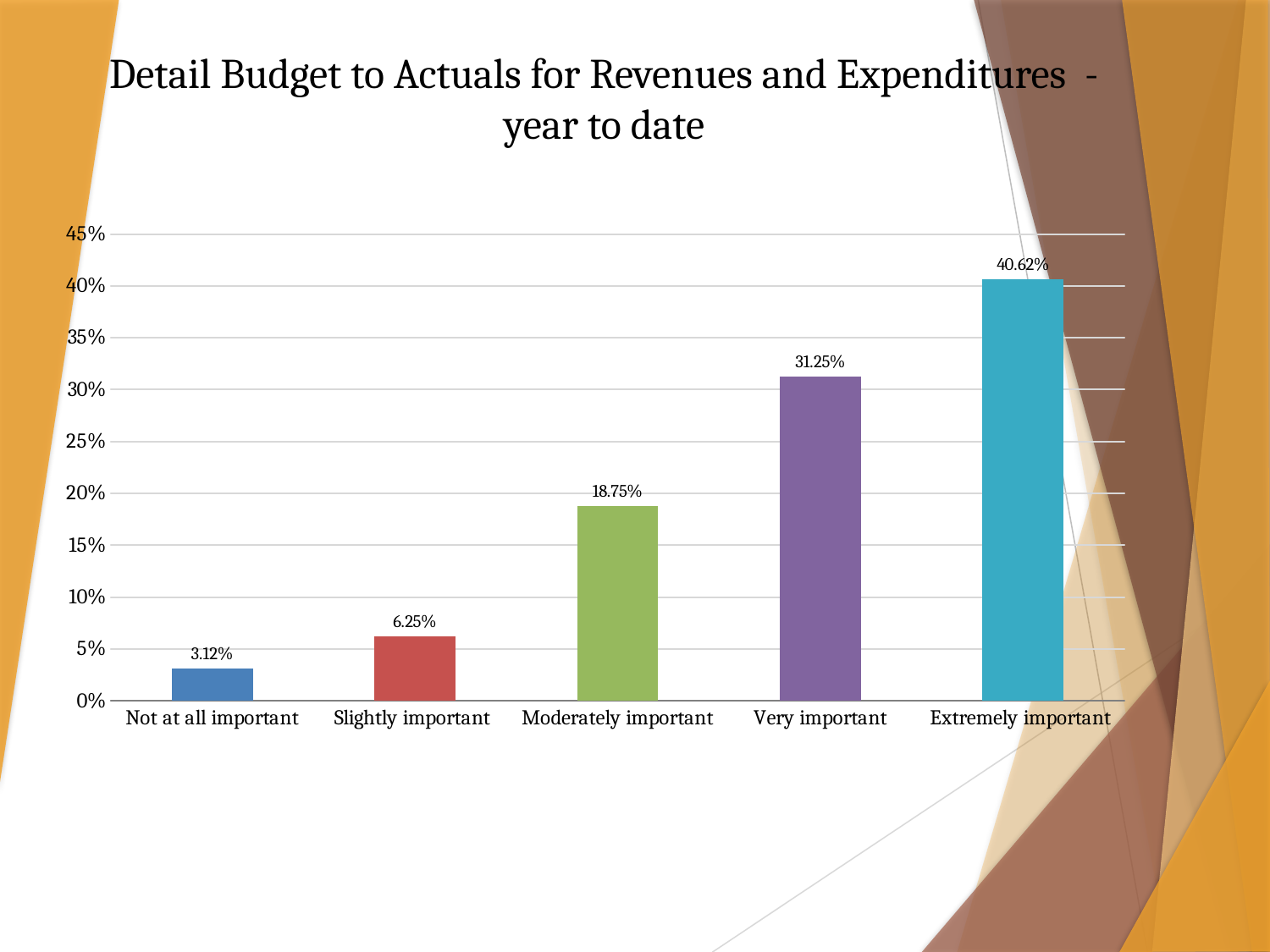
What is the value for Moderately important? 18.75% What is the difference between the values for Extremely important and Very important? 9.37% Do the values rise or fall from left to right along the x axis? rise Which category has the lowest value? Not at all important Which category has the highest value? Extremely important What is the value for Extremely important? 40.62% What kind of chart is shown on the slide? bar chart How many categories are shown on the x axis? 5 What is the value for Not at all important? 3.12% Which is larger, the value for Very important or the value for Moderately important? Very important What is the difference between the values for Slightly important and Not at all important? 3.13% Is the value for Very important greater or less than 30%? greater